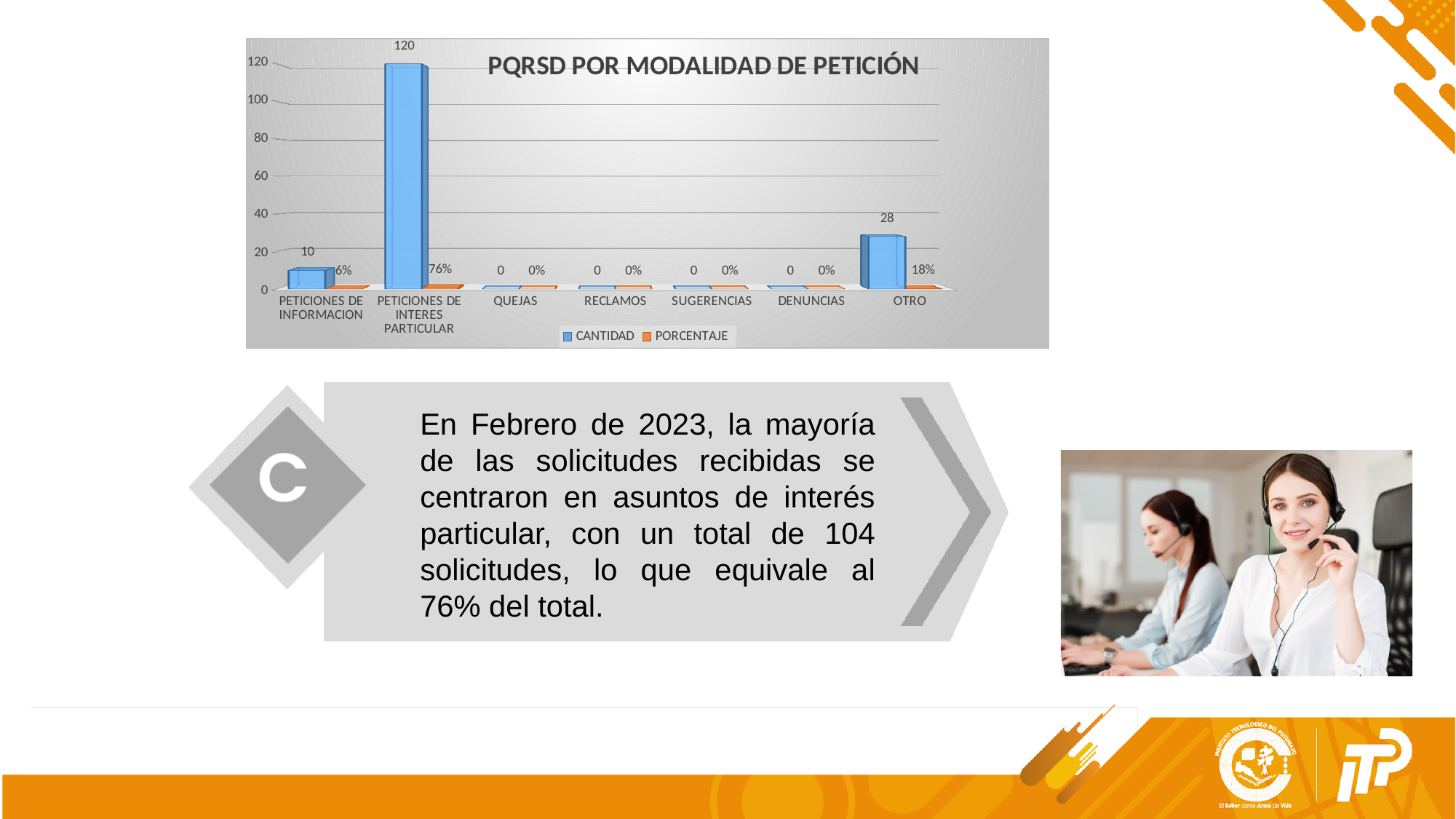
What is the CANTIDAD value for PETICIONES DE INTERES PARTICULAR? 120 What is the difference in CANTIDAD between PETICIONES DE INTERES PARTICULAR and OTRO? 92 What is the PORCENTAJE value for OTRO? 18% Which category has the highest CANTIDAD value? PETICIONES DE INTERES PARTICULAR What is the PORCENTAJE value for PETICIONES DE INFORMACION? 6% What is the CANTIDAD value for QUEJAS? 0 Which has a larger CANTIDAD value, PETICIONES DE INFORMACION or OTRO? OTRO How many categories are shown on the x axis? 7 What is the CANTIDAD value for OTRO? 28 What kind of chart is shown on the slide? Bar chart What is the title of the chart? PQRSD POR MODALIDAD DE PETICIÓN How many series does the legend list? 2